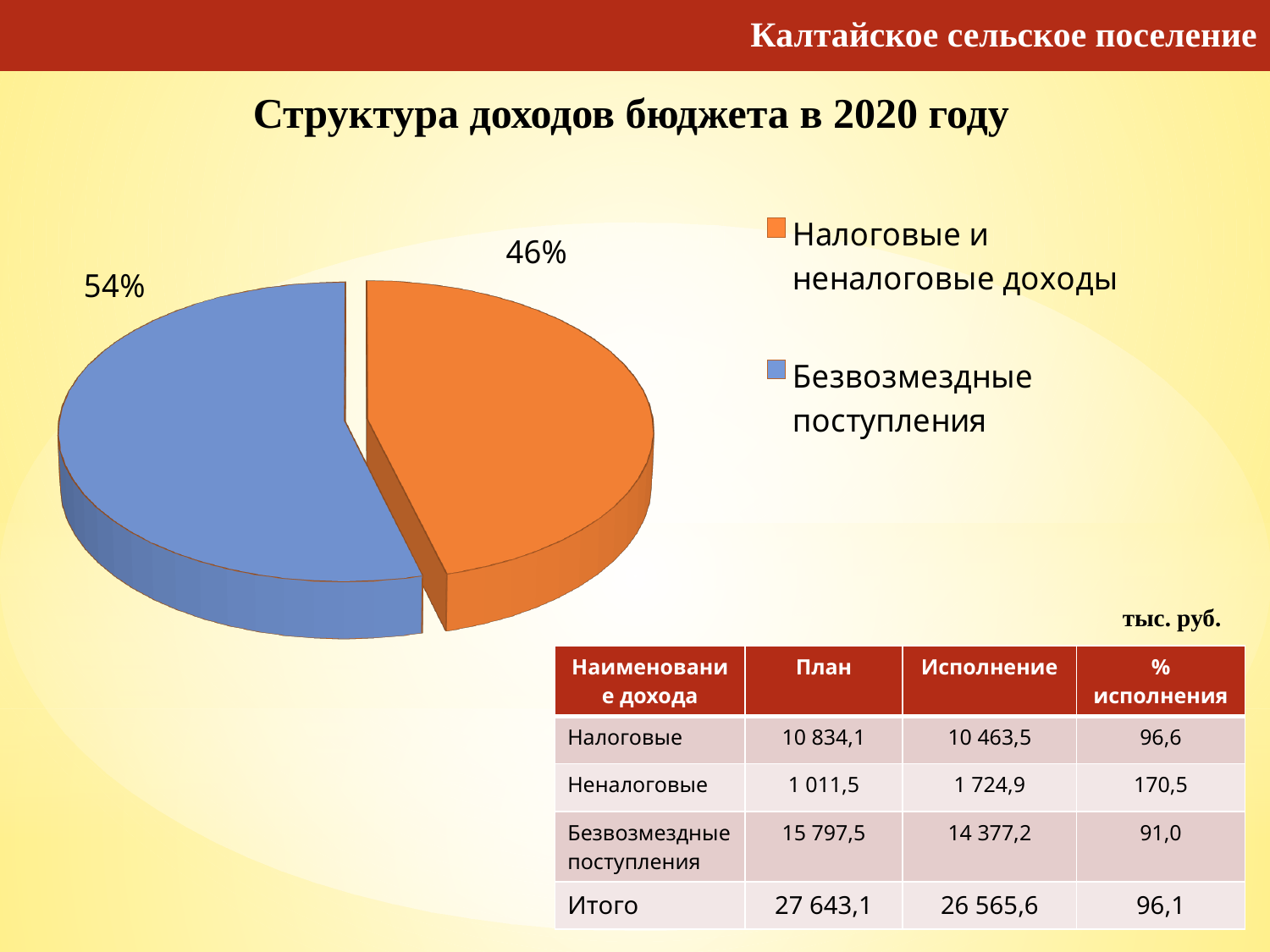
What colour is the slice for "Безвозмездные поступления"? Blue Is the share for "Налоговые и неналоговые доходы" greater or less than 50%? less Which slice is larger: "Налоговые и неналоговые доходы" or "Безвозмездные поступления"? Безвозмездные поступления How many entries does the chart legend list? 2 Which category has the largest slice of the pie? Безвозмездные поступления What is the title of the chart on the slide? Структура доходов бюджета в 2020 году What type of chart is shown on the slide? Pie chart What share of the pie does "Безвозмездные поступления" have? 54% What share of the pie does "Налоговые и неналоговые доходы" have? 46% What is the difference in percentage points between the "Безвозмездные поступления" slice and the "Налоговые и неналоговые доходы" slice? 8 percentage points How many slices does the pie chart have? 2 Which category has the smallest slice of the pie? Налоговые и неналоговые доходы